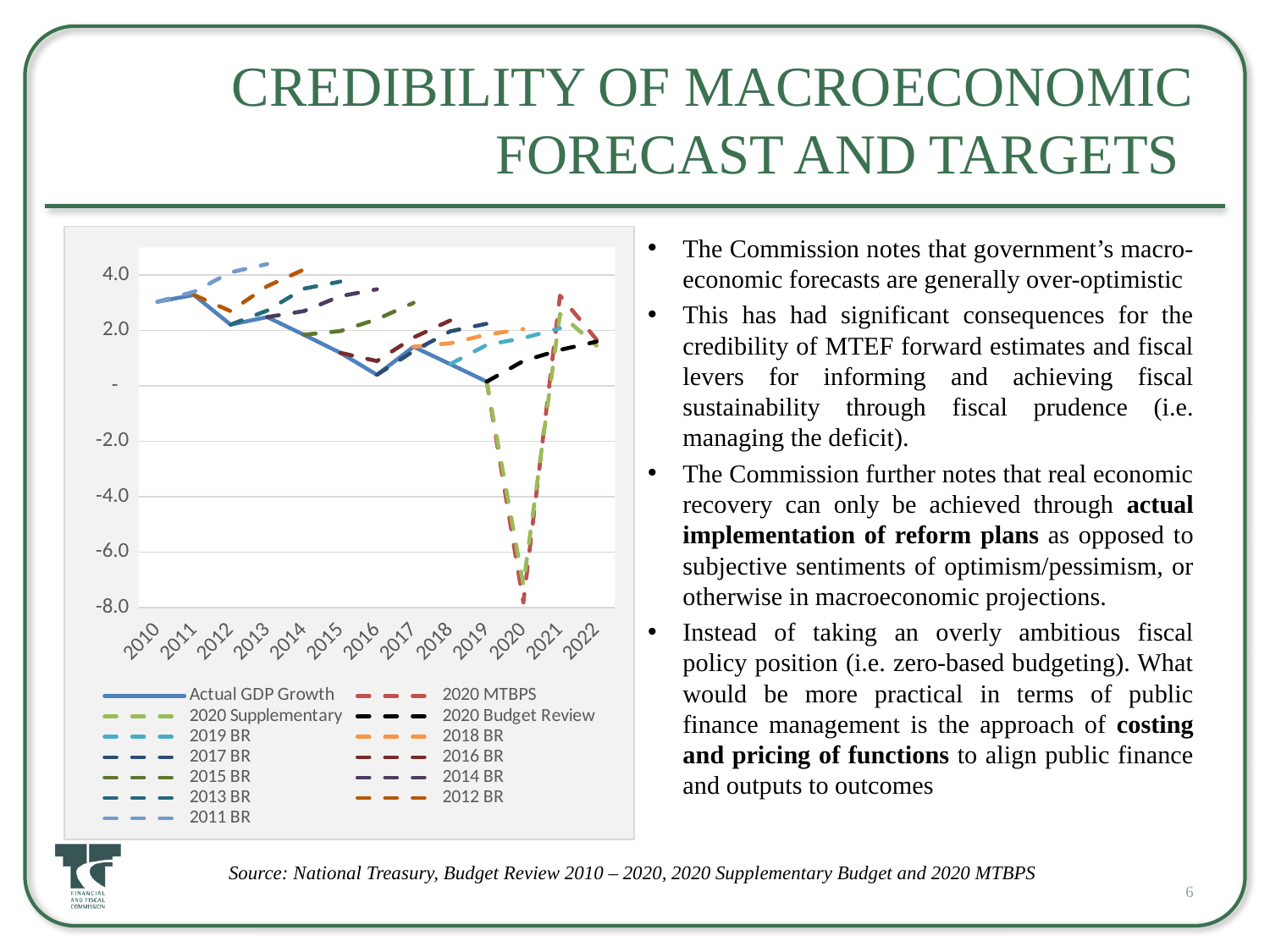
Does the Actual GDP Growth line generally rise or fall from 2010 to 2019? fall Is the Actual GDP Growth value for 2010 greater or less than 2.0? greater Is the Actual GDP Growth value for 2016 greater or less than 2.0? less Is the 2020 Supplementary value for 2020 greater or less than -6.0? less How many years are shown along the x axis of the chart? 13 What kind of chart is shown on the slide? line chart Which series in the legend is drawn as a solid line rather than a dashed line? Actual GDP Growth In which year does the chart reach its lowest plotted value? 2020 How many series does the chart's legend list? 13 What is the lowest value shown on the chart's y axis? -8.0